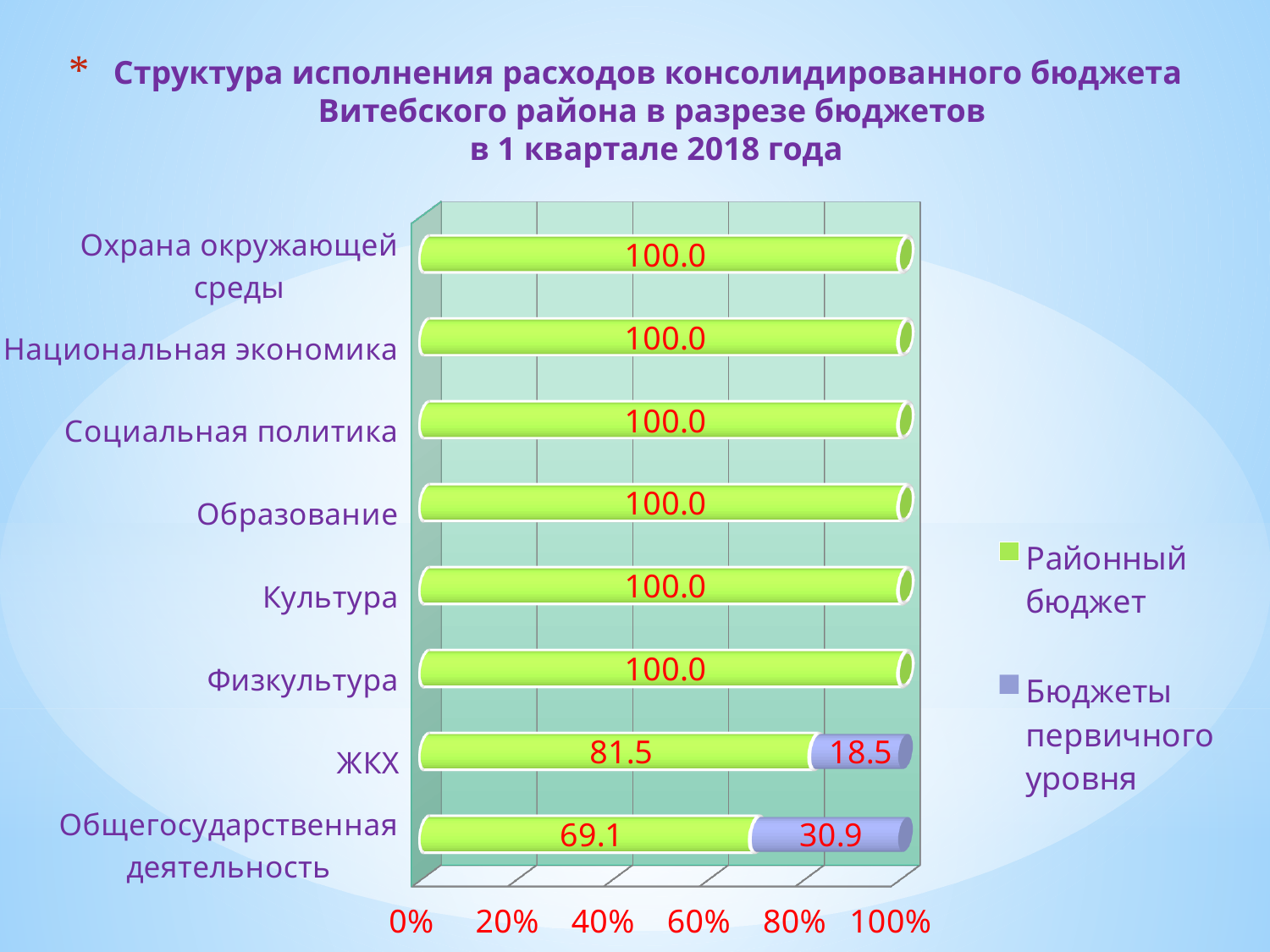
How many series does the legend list? 2 Which category has the lowest value for Районный бюджет? Общегосударственная деятельность What is the value of Бюджеты первичного уровня for Общегосударственная деятельность? 30.9 What is the value of Районный бюджет for Общегосударственная деятельность? 69.1 What is the value of Бюджеты первичного уровня for ЖКХ? 18.5 What is the value of Районный бюджет for ЖКХ? 81.5 Which category has the larger Районный бюджет value: ЖКХ or Общегосударственная деятельность? ЖКХ Which category has the highest value for Бюджеты первичного уровня? Общегосударственная деятельность What is the difference between the Районный бюджет values for ЖКХ and Общегосударственная деятельность? 12.4 How many categories are shown on the chart? 8 What is the total of the stacked bar for ЖКХ? 100.0 What kind of chart is shown on the slide? Bar chart